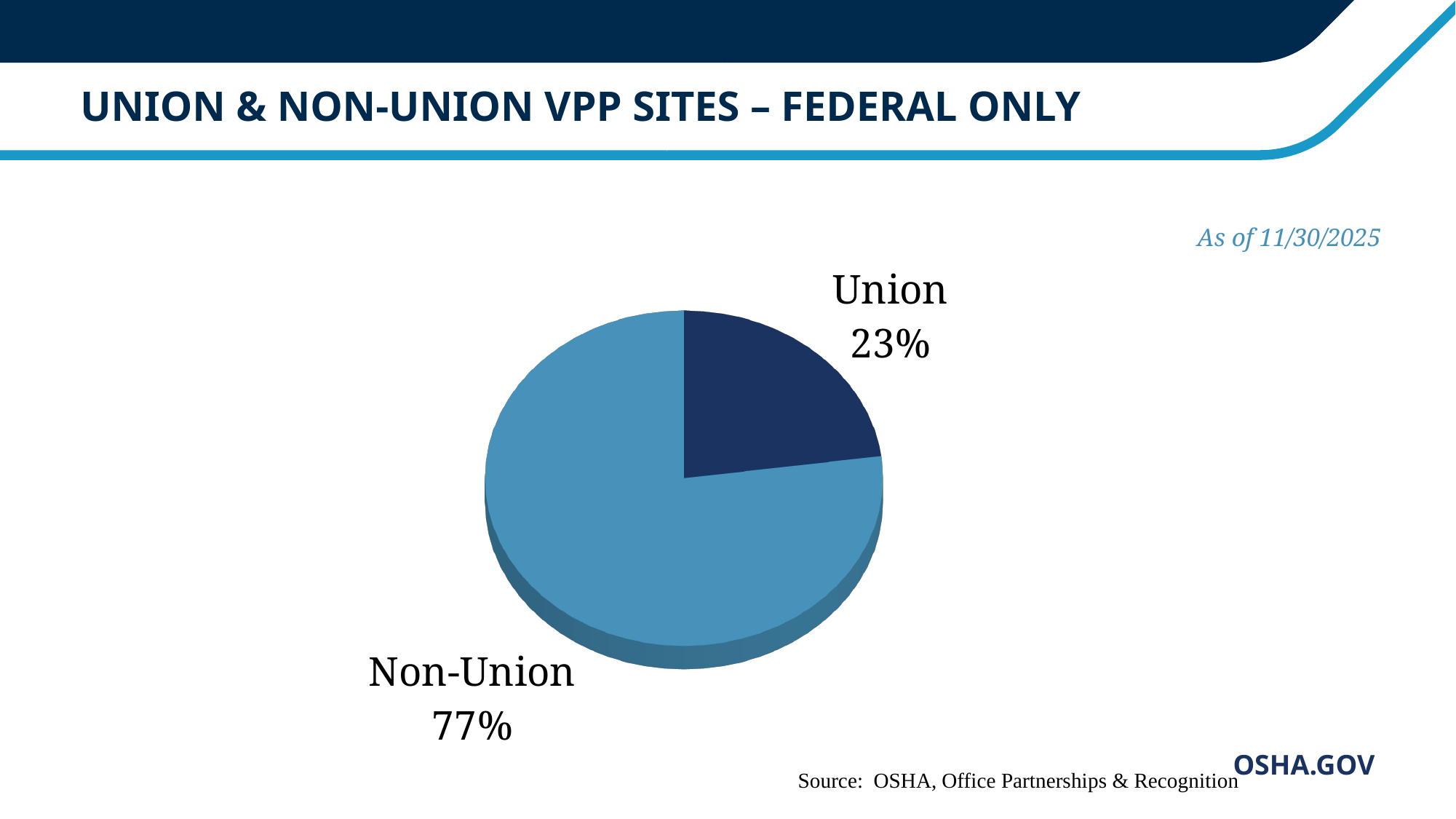
Is the Union share greater or less than 25%? less Is the Non-Union share greater or less than 75%? greater What share of the pie does the Non-Union slice represent? 77% Which is larger, the Union share or the Non-Union share? Non-Union Which category has the smallest slice of the pie? Union What is the title of the chart on the slide? UNION & NON-UNION VPP SITES – FEDERAL ONLY As of what date is the chart data reported? 11/30/2025 What kind of chart is shown on the slide? Pie chart Which category has the largest slice of the pie? Non-Union What share of the pie does the Union slice represent? 23% What is the difference in percentage points between the Non-Union and Union shares? 54 How many categories are shown in the pie chart? 2